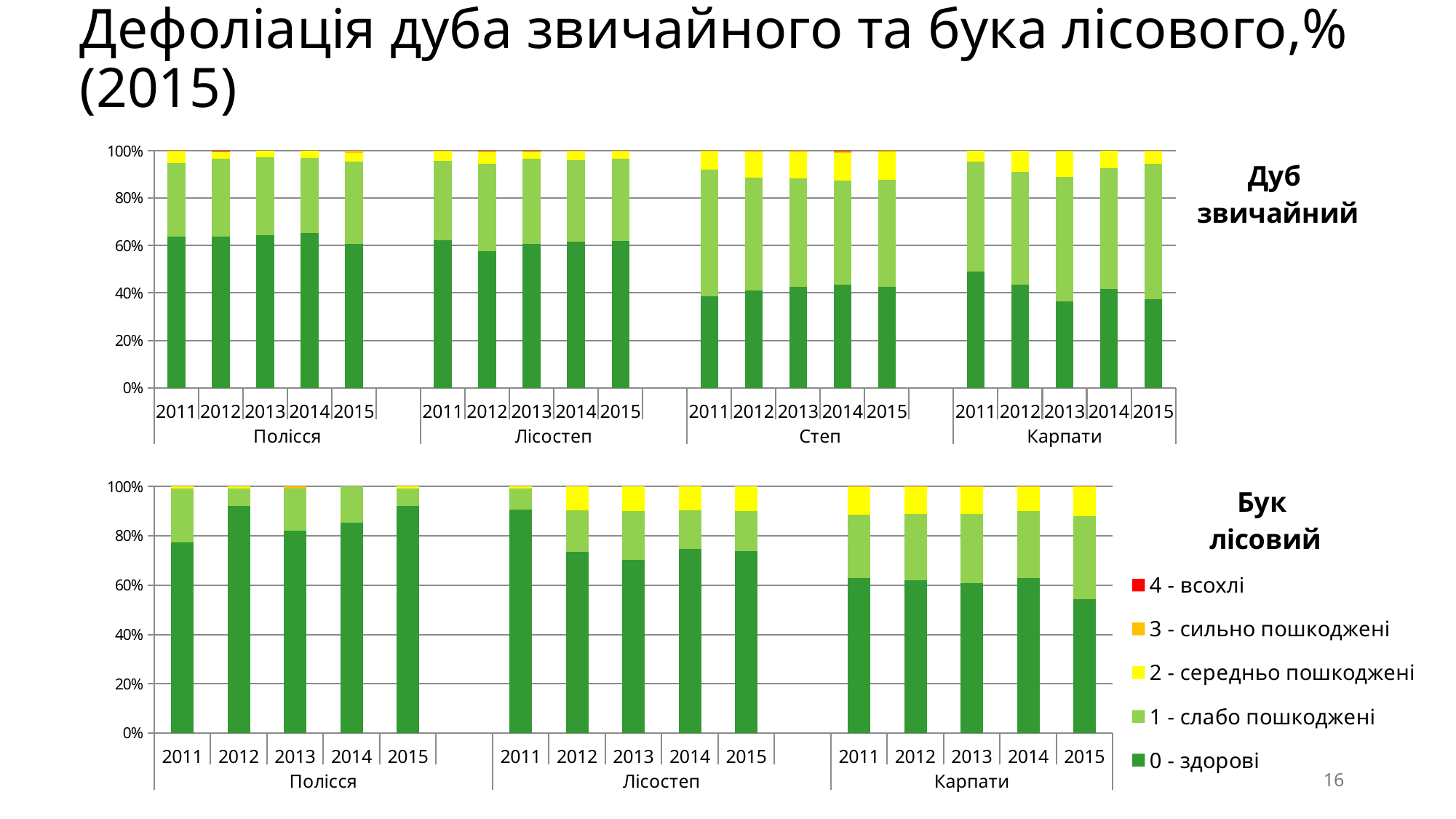
In the bottom chart (Бук лісовий), does the share of '0 - здорові' for Карпати rise or fall from 2014 to 2015? fall How many series does the legend list? 5 How many regions are shown on the x axis of the top chart (Дуб звичайний)? 4 What kind of chart is the top chart (Дуб звичайний)? Stacked bar chart How many regions are shown on the x axis of the bottom chart (Бук лісовий)? 3 What colour represents the '0 - здорові' series in the legend? Green In the top chart (Дуб звичайний), is the share of '0 - здорові' for Карпати in 2013 greater or less than 40%? less In the top chart (Дуб звичайний), which has the larger share of '0 - здорові' in 2011: Полісся or Степ? Полісся In the bottom chart (Бук лісовий), is the share of '0 - здорові' for Карпати in 2015 greater or less than 60%? less In the bottom chart (Бук лісовий), is the share of '0 - здорові' for Полісся in 2012 greater or less than 80%? greater In the bottom chart (Бук лісовий), which region has the lowest share of '0 - здорові' in 2015? Карпати